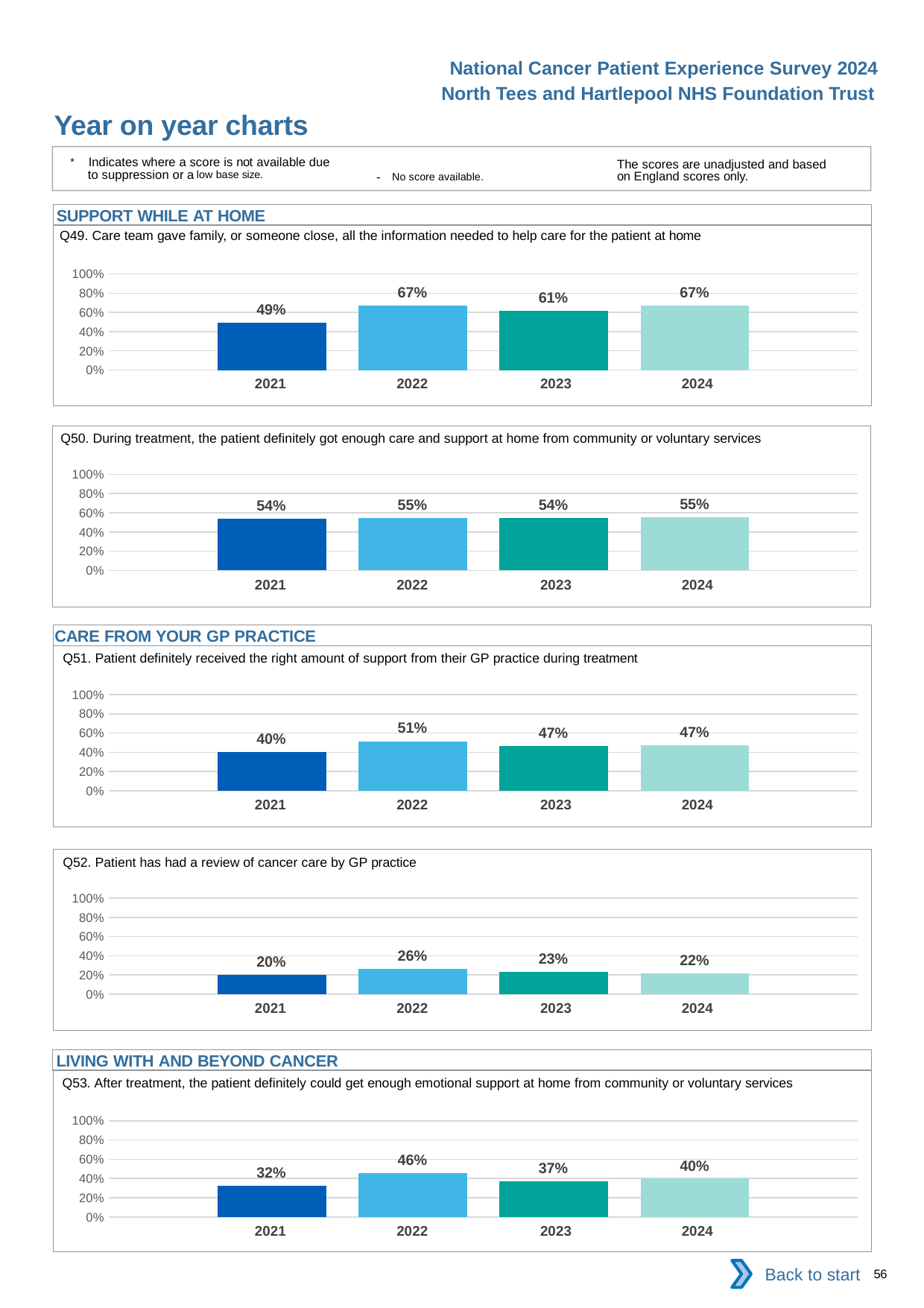
What kind of chart is the Q52 chart? Bar chart In the Q49 chart, what is the value for 2021? 49% In the Q53 chart, what is the difference between the 2022 and 2021 values? 14% In the Q52 chart, is the value for 2022 greater or less than 40%? less In the Q51 chart, which year has the highest value? 2022 In the Q53 chart, which is larger, the value for 2023 or the value for 2024? 2024 In the Q49 chart, what is the difference between the 2022 and 2023 values? 6% How many years are shown on the x axis of the Q50 chart? 4 How many charts are shown on the slide? 5 In the Q50 chart, what is the value for 2024? 55% In the Q51 chart, which year has the lowest value? 2021 In the Q52 chart, what is the value for 2023? 23%